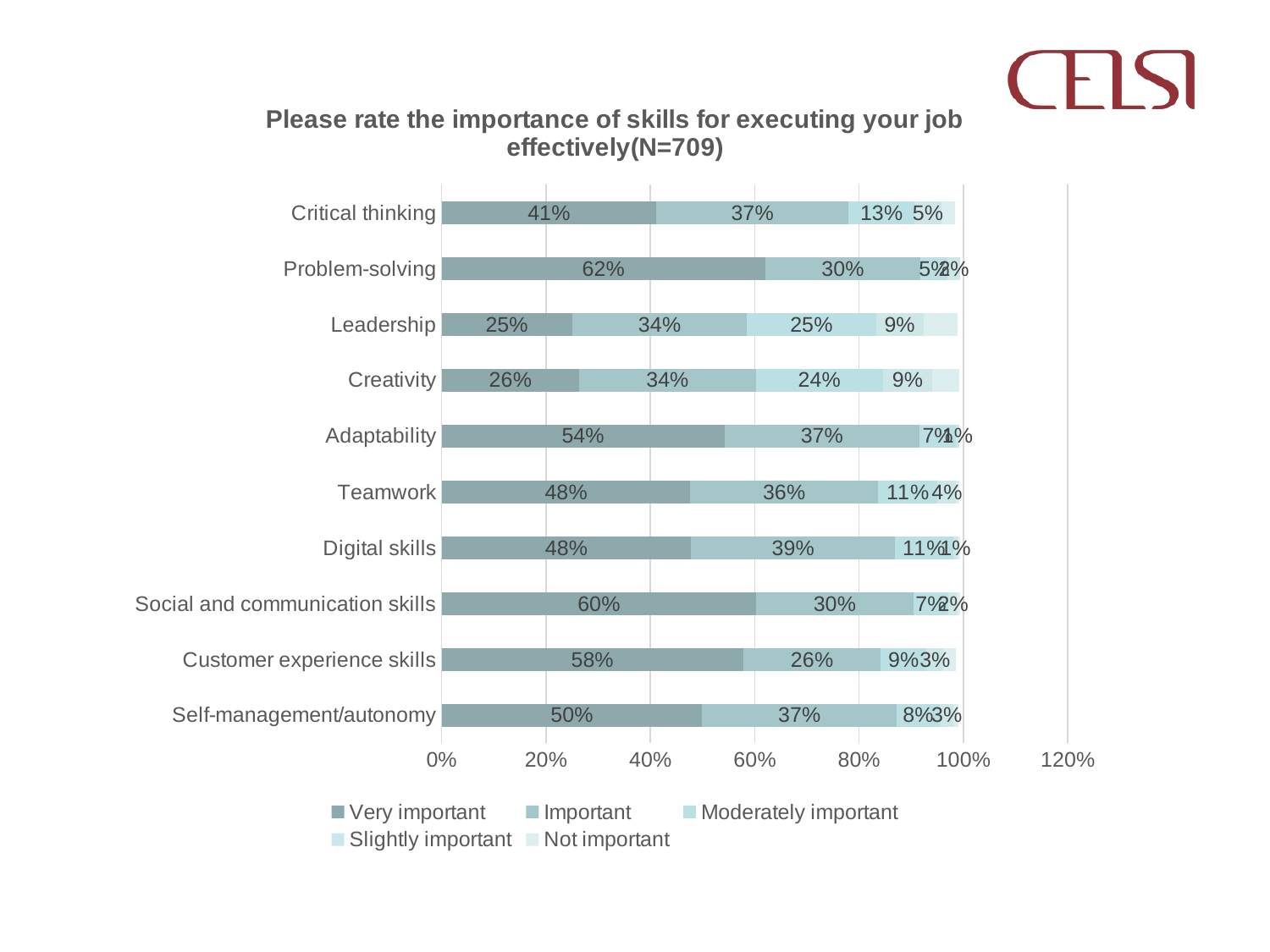
What percentage of respondents rated Problem-solving as Very important? 62% Which skill has the lowest Very important percentage? Leadership What type of chart is shown on the slide? Stacked bar chart Which skill has the highest Very important percentage? Problem-solving What sample size (N) is stated in the chart title? 709 What percentage of respondents rated Leadership as Important? 34% What is the Very important value for Self-management/autonomy? 50% What is the Moderately important value for Critical thinking? 13% How many series does the legend list? 5 How many skills are listed on the chart? 10 What is the difference between the Very important percentages for Problem-solving and Critical thinking? 21% Which has a larger Very important percentage, Customer experience skills or Teamwork? Customer experience skills